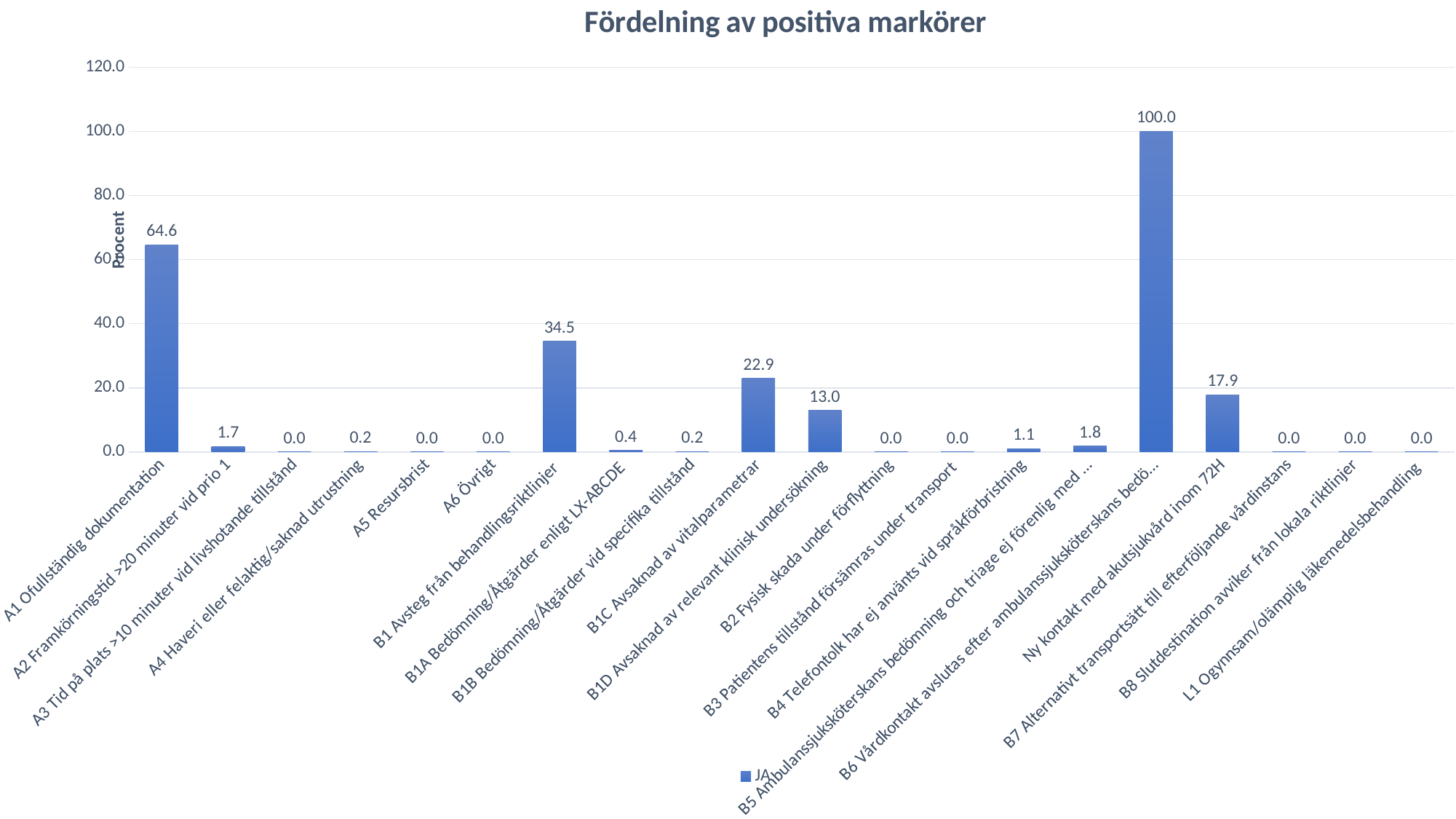
What is the difference between the values for A1 Ofullständig dokumentation and B1 Avsteg från behandlingsriktlinjer? 30.1 What is the value for B1 Avsteg från behandlingsriktlinjer? 34.5 What is the title of the chart? Fördelning av positiva markörer How many categories are shown on the x axis? 20 Is the value for A1 Ofullständig dokumentation greater or less than 60.0? greater What is the value for Ny kontakt med akutsjukvård inom 72H? 17.9 How many series does the legend list? 1 What is the value for A1 Ofullständig dokumentation? 64.6 What kind of chart is shown? bar chart Which category has the highest value? B6 Vårdkontakt avslutas efter ambulanssjuksköterskans bedö... What is the value for B1C Avsaknad av vitalparametrar? 22.9 Which is larger, the value for B1C Avsaknad av vitalparametrar or B1D Avsaknad av relevant klinisk undersökning? B1C Avsaknad av vitalparametrar